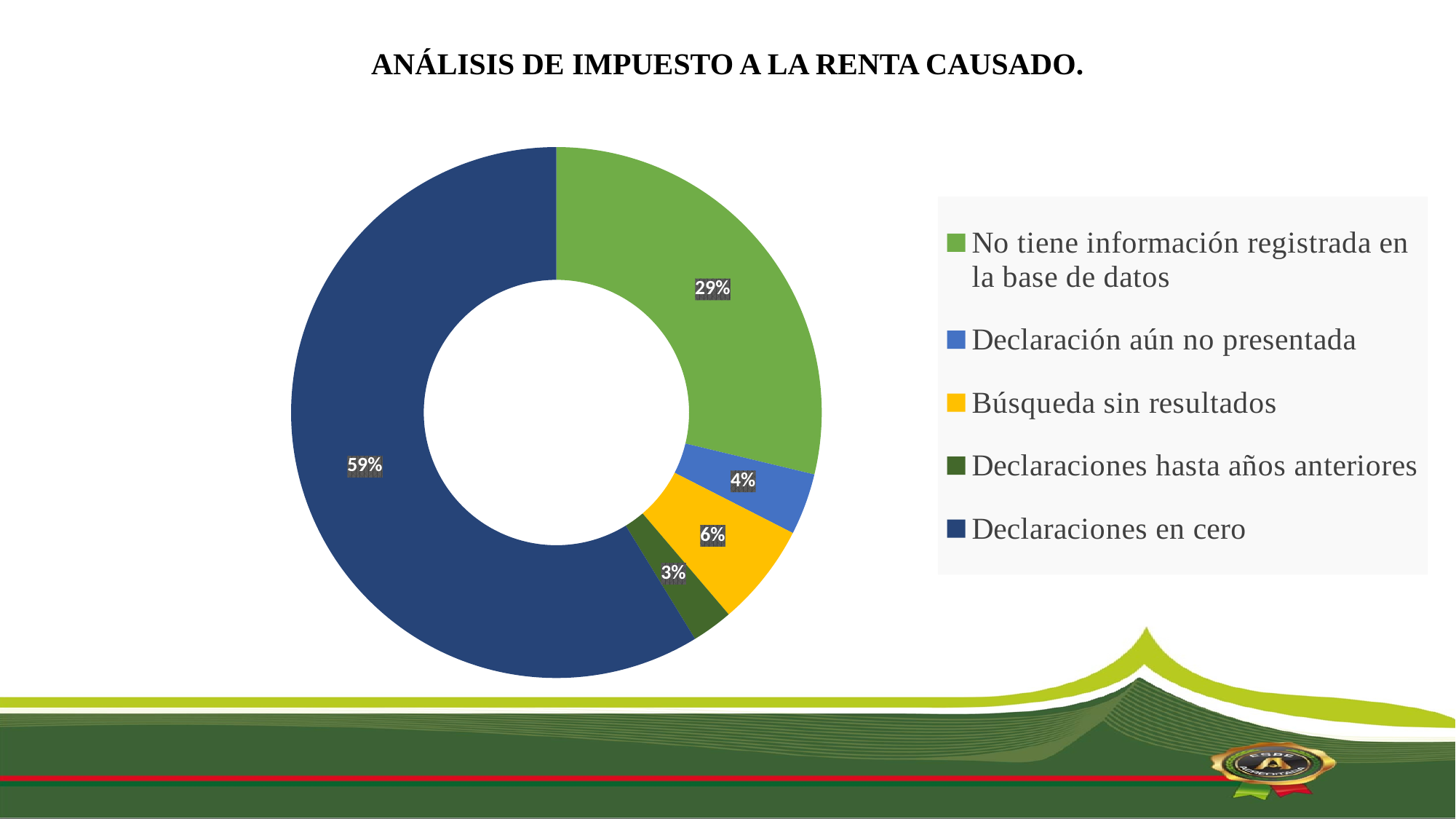
Which is larger, the share for 'Búsqueda sin resultados' or the share for 'Declaración aún no presentada'? Búsqueda sin resultados Which category has the largest share of the chart? Declaraciones en cero Which category has the smallest share of the chart? Declaraciones hasta años anteriores What is the value shown for 'Declaraciones hasta años anteriores'? 3% What is the value shown for 'Búsqueda sin resultados'? 6% What share of the pie does 'No tiene información registrada en la base de datos' represent? 29% What share of the pie does 'Declaraciones en cero' represent? 59% What kind of chart is shown on the slide? Pie chart (doughnut) What is the value shown for 'Declaración aún no presentada'? 4% What is the title of the chart? ANÁLISIS DE IMPUESTO A LA RENTA CAUSADO. How many categories does the chart show? 5 What is the difference between the shares of 'Declaraciones en cero' and 'No tiene información registrada en la base de datos'? 30%